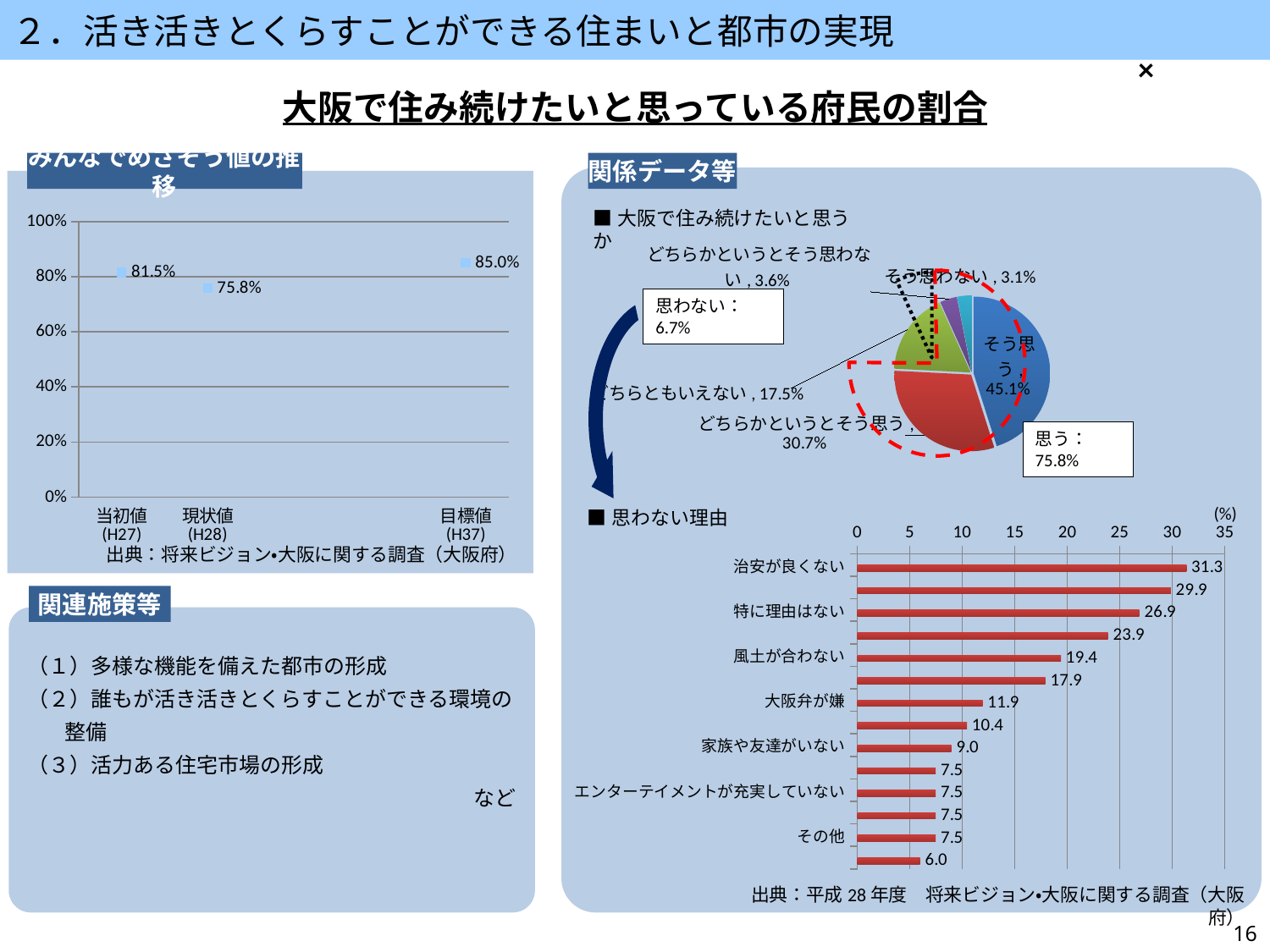
In the pie chart 大阪で住み続けたいと思うか, how many slices are there? 5 In the left chart titled みんなでめざそう値の推移, what is the value for 当初値 (H27)? 81.5% In the left chart titled みんなでめざそう値の推移, what is the difference between 目標値 (H37) and 現状値 (H28)? 9.2% In the left chart titled みんなでめざそう値の推移, what is the value for 目標値 (H37)? 85.0% What kind of chart is the 思わない理由 chart? bar chart In the bar chart 思わない理由, which reason has the highest value? 治安が良くない In the pie chart 大阪で住み続けたいと思うか, what is the share for そう思う? 45.1% In the bar chart 思わない理由, which is larger: 風土が合わない or 大阪弁が嫌? 風土が合わない In the bar chart 思わない理由, what is the value for 治安が良くない? 31.3 In the pie chart 大阪で住み続けたいと思うか, which slice is the largest? そう思う In the pie chart 大阪で住み続けたいと思うか, what is the difference between そう思う and どちらかというとそう思う? 14.4% In the left chart titled みんなでめざそう値の推移, which category has the lowest value? 現状値 (H28)